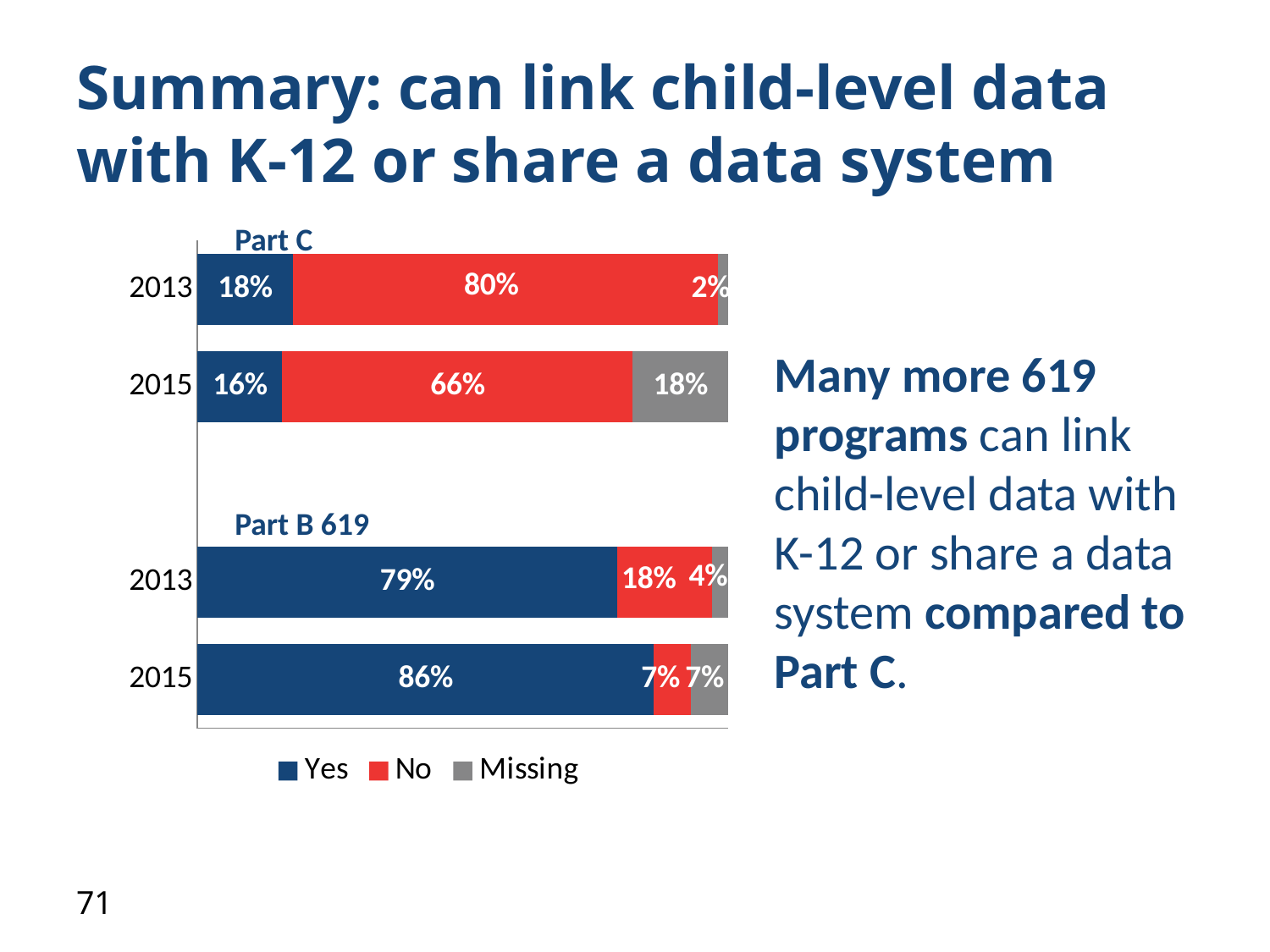
What is the 'Yes' value for Part C in 2013? 18% What is the 'Missing' value for Part C in 2015? 18% How many series does the legend list? 3 What kind of chart is shown on the slide? Stacked bar chart What is the difference between the 'Yes' value for Part B 619 in 2015 and in 2013? 7% Which is larger: the 'No' value for Part C in 2013 or the 'No' value for Part B 619 in 2013? Part C in 2013 Which bar has the highest 'Yes' value? Part B 619, 2015 What is the 'Yes' value for Part B 619 in 2015? 86% Which bar has the lowest 'Yes' value? Part C, 2015 How many bars are plotted in the chart? 4 What is the 'No' value for Part B 619 in 2013? 18% What is the 'No' value for Part C in 2015? 66%